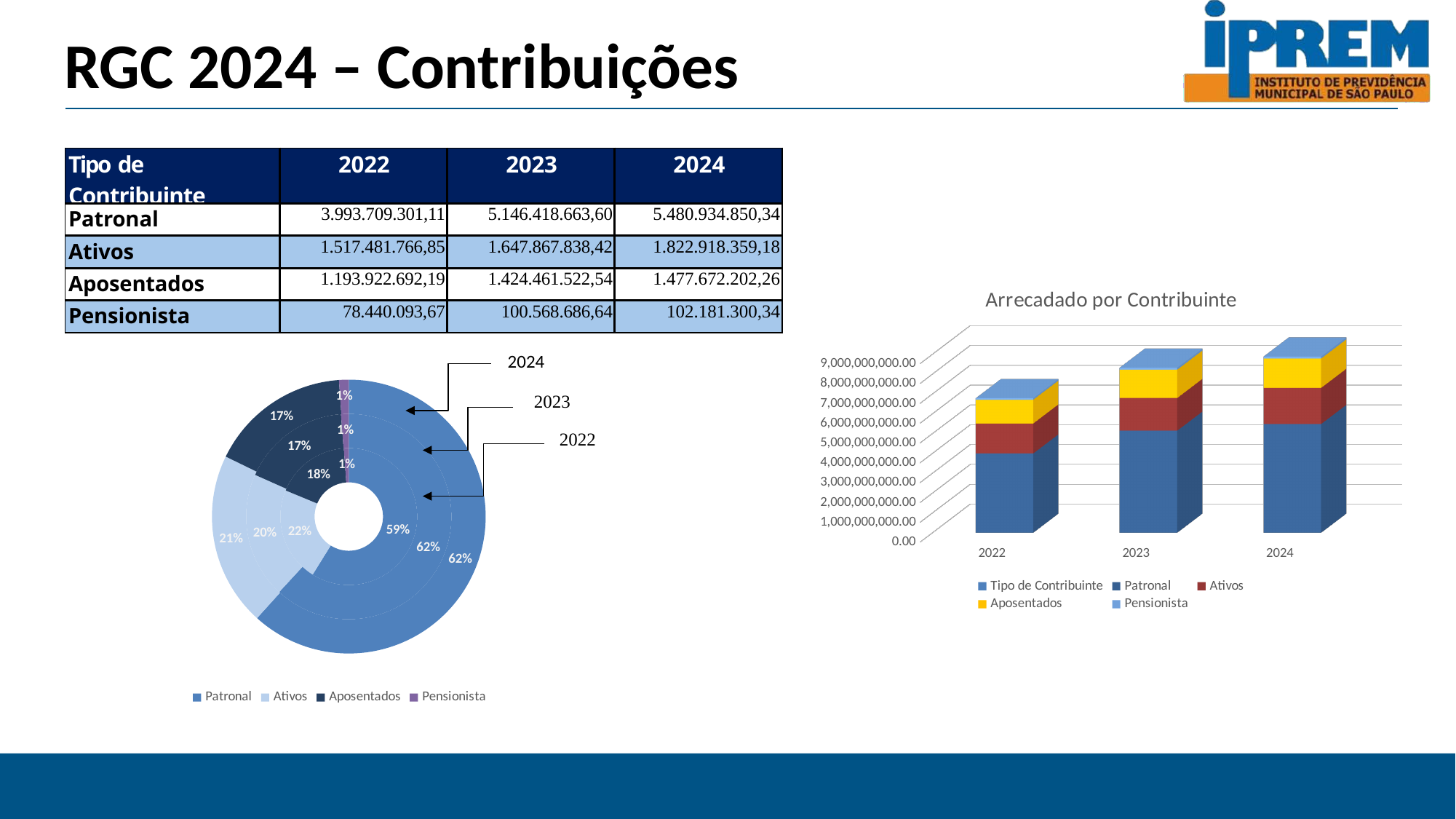
In the chart titled 'Arrecadado por Contribuinte', how many years are shown on the x axis? 3 In the doughnut chart on the left, what share does Ativos have in the 2024 ring? 21% What kind of chart is 'Arrecadado por Contribuinte'? Stacked bar chart In the chart titled 'Arrecadado por Contribuinte', is the total bar for 2024 greater or less than 8,000,000,000.00? greater In the doughnut chart on the left, what share does Aposentados have in the 2023 ring? 17% In the chart titled 'Arrecadado por Contribuinte', how many series does the legend list? 5 In the doughnut chart on the left, which category has the smallest share in every ring? Pensionista In the chart titled 'Arrecadado por Contribuinte', do the total bar heights rise or fall from 2022 to 2024? rise In the doughnut chart on the left, what share does Patronal have in the 2022 ring? 59% In the doughnut chart on the left, how many categories does the legend list? 4 In the doughnut chart on the left, which category has the largest share in every ring? Patronal